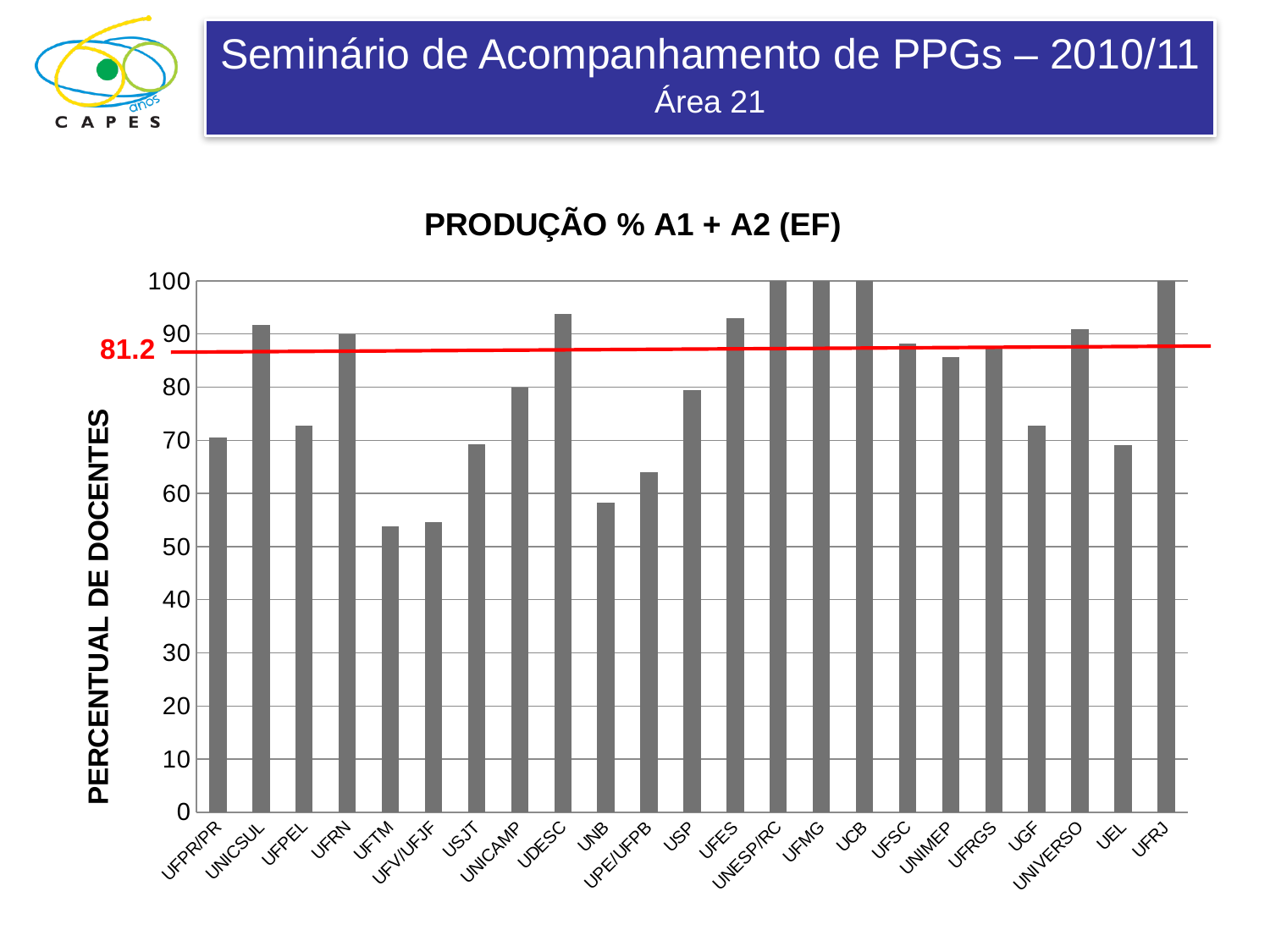
Is the value for UFTM greater or less than 60? less Which is larger, the value for UNB or the value for UFES? UFES How many bars reach the value 100? 4 What is the value for UFMG? 100 What is the title of the chart? PRODUÇÃO % A1 + A2 (EF) How many institutions (categories) are shown on the x axis of the chart? 23 Is the value for UDESC greater or less than 90? greater Is the value for UNIMEP greater or less than 80? greater What kind of chart is shown on the slide? Bar chart What value is labelled on the red horizontal line across the chart? 81.2 What is the value for UFRJ? 100 Which is larger, the value for UNICSUL or the value for UFPEL? UNICSUL